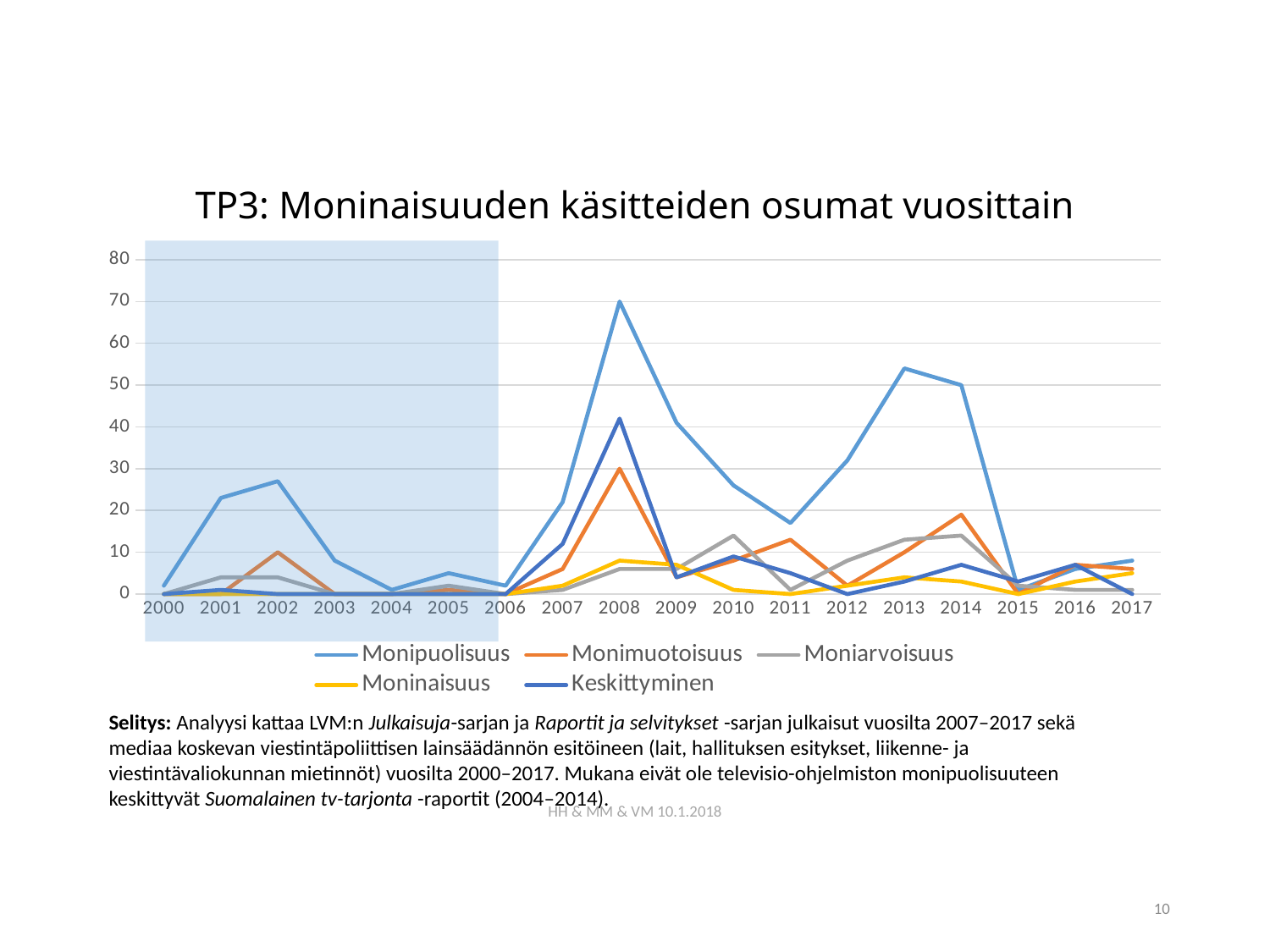
Is the value for Monipuolisuus in 2011 greater or less than 20? less What is the title of the chart? TP3: Moninaisuuden käsitteiden osumat vuosittain How many years are shown on the x axis? 18 Is the value for Monipuolisuus in 2013 greater or less than 50? greater Does the Monipuolisuus series rise or fall from 2014 to 2015? fall In 2014, which is larger: Monimuotoisuus or Moniarvoisuus? Monimuotoisuus What kind of chart is shown on the slide? line chart What is the value of Monimuotoisuus in 2008? 30 What is the value of Monipuolisuus in 2008? 70 How many series does the legend list? 5 Which series has the highest value in 2008? Monipuolisuus In which year does the Monipuolisuus series reach its highest value? 2008